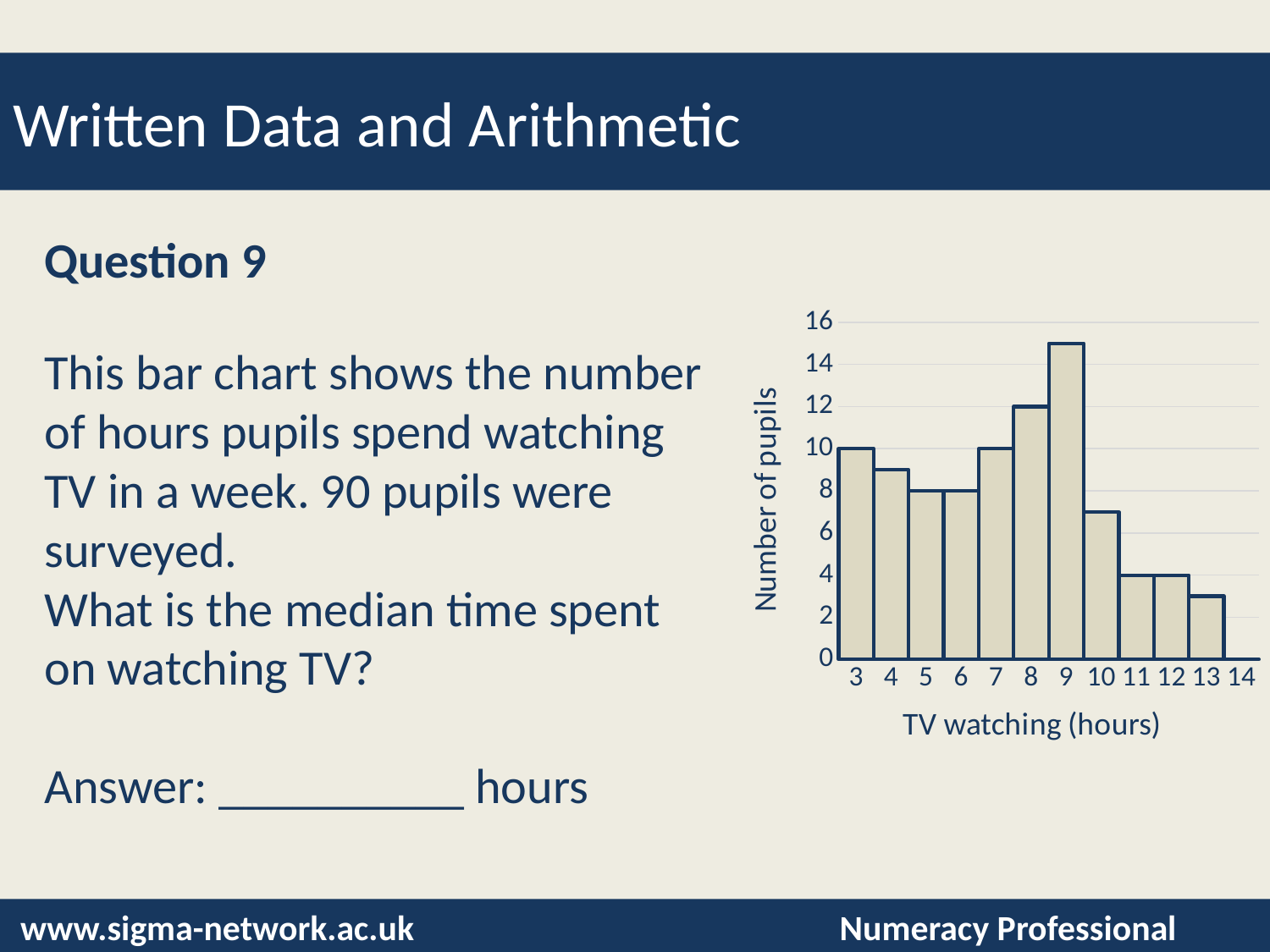
How many bars are plotted in the chart? 11 Which number of hours has the lowest number of pupils? 13 What kind of chart is shown on the slide? bar chart Which has more pupils, 7 hours or 5 hours? 7 hours Is the number of pupils for 9 hours greater or less than 14? greater Do the values rise or fall from 9 hours to 13 hours? fall What is the difference between the number of pupils for 8 hours and for 11 hours? 8 What is the label on the vertical axis of the chart? Number of pupils How many pupils watch TV for 8 hours a week? 12 Which number of hours has the highest number of pupils? 9 How many pupils watch TV for 3 hours a week? 10 Is the number of pupils for 10 hours greater or less than 8? less